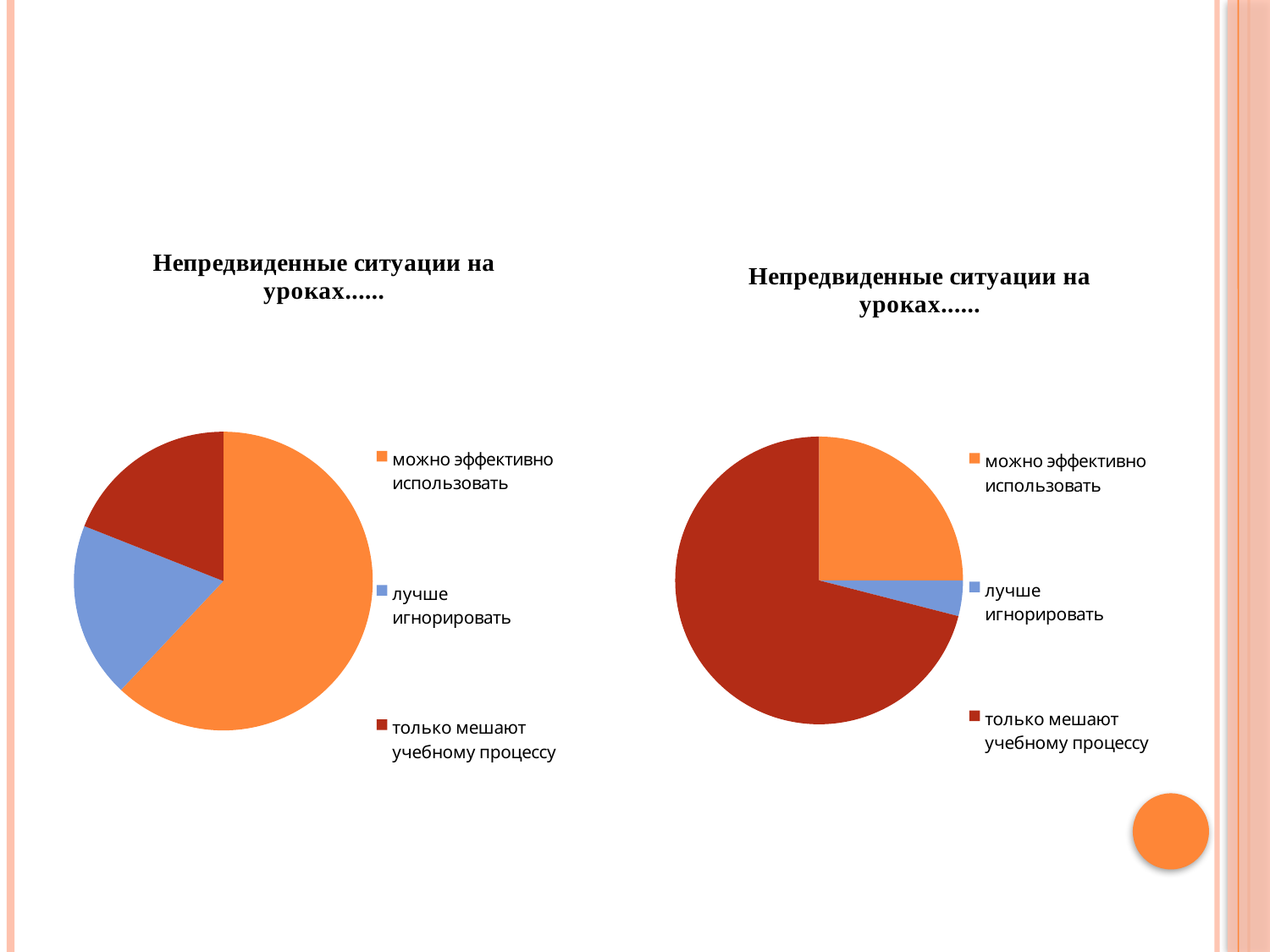
What kind of chart is the right chart on the slide? pie chart What is the title of the left chart? Непредвиденные ситуации на уроках...... In the right pie chart, which category has the smallest slice? лучше игнорировать In the left pie chart, how many slices does the pie have? 3 In the right pie chart, which category has the largest slice? только мешают учебному процессу In the right pie chart, what colour is the slice for 'лучше игнорировать'? blue In the right pie chart, how many entries does the legend list? 3 In the left pie chart, which category has the largest slice? можно эффективно использовать In the right pie chart, which slice is larger: 'можно эффективно использовать' or 'только мешают учебному процессу'? только мешают учебному процессу In the left pie chart, which slice is larger: 'можно эффективно использовать' or 'только мешают учебному процессу'? можно эффективно использовать What kind of chart is the left chart on the slide? pie chart